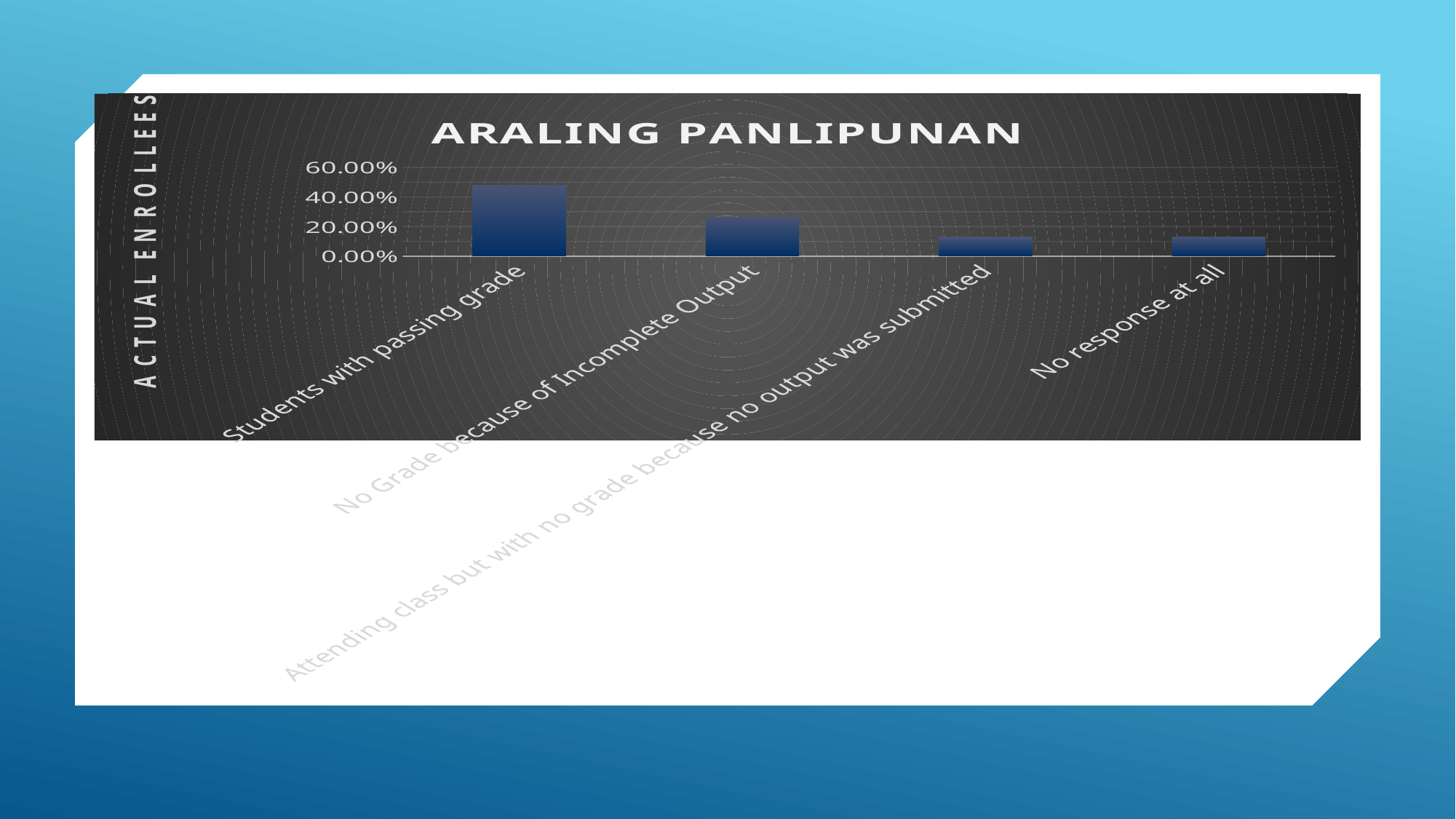
Do the values generally rise or fall from left to right across the categories? fall Is the value for No Grade because of Incomplete Output greater or less than 20.00%? greater Which is larger: the value for No Grade because of Incomplete Output or the value for No response at all? No Grade because of Incomplete Output How many categories are plotted in the chart? 4 What is the title of the chart? ARALING PANLIPUNAN Is the value for No response at all greater or less than 20.00%? less Which is larger: the value for Students with passing grade or the value for No Grade because of Incomplete Output? Students with passing grade What kind of chart is shown on the slide? bar chart Is the value for Students with passing grade greater or less than 40.00%? greater What is the label on the vertical axis of the chart? ACTUAL ENROLLEES Which category has the highest value? Students with passing grade